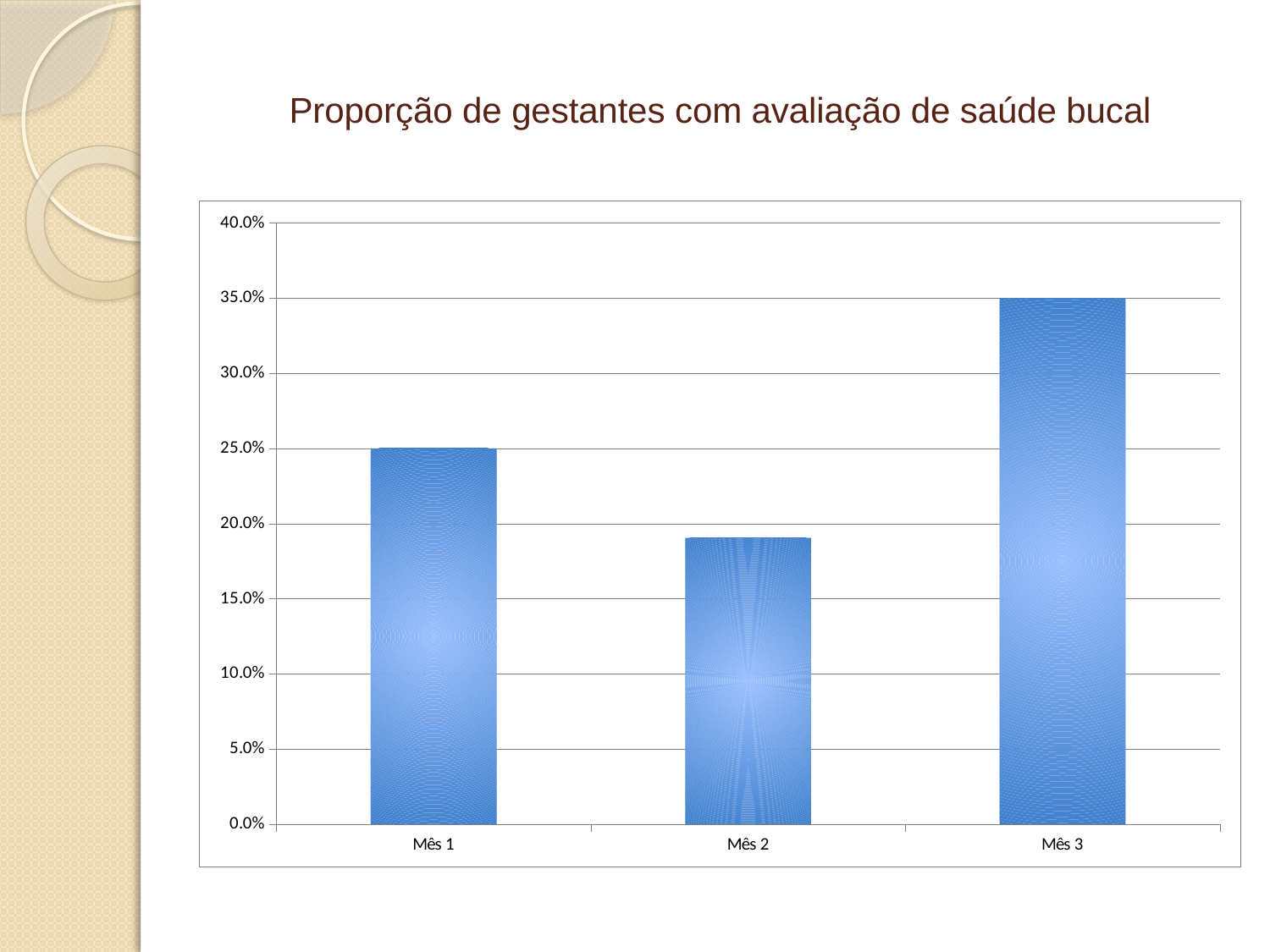
What is the value for Mês 1? 25.0% What is the difference between the values for Mês 3 and Mês 1? 10.0% What is the value for Mês 3? 35.0% Which month has the lowest value? Mês 2 Which is larger, the value for Mês 1 or the value for Mês 2? Mês 1 What is the maximum value shown on the y axis? 40.0% Is the value for Mês 2 greater or less than 15.0%? greater What is the title of the slide? Proporção de gestantes com avaliação de saúde bucal Which month has the highest value? Mês 3 How many categories are shown on the x axis? 3 What type of chart is shown on the slide? bar chart Is the value for Mês 2 greater or less than 20.0%? less